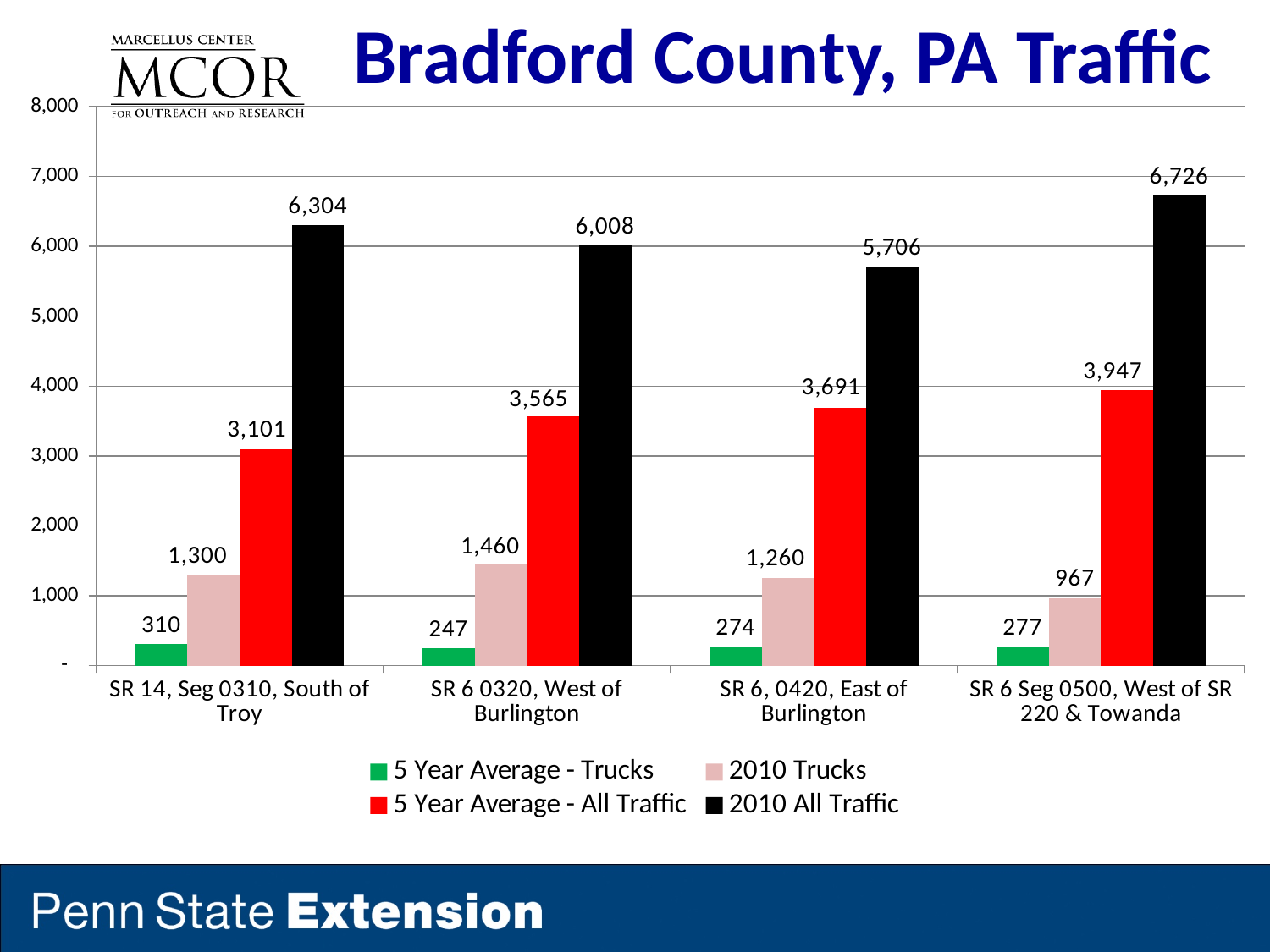
Which is larger for SR 6 0320, West of Burlington: the 2010 Trucks value or the 5 Year Average - Trucks value? 2010 Trucks What is the 2010 Trucks value for SR 6 0320, West of Burlington? 1,460 What colour are the bars for the 2010 All Traffic series? Black What is the 2010 All Traffic value for SR 6 Seg 0500, West of SR 220 & Towanda? 6,726 What is the 5 Year Average - All Traffic value for SR 6, 0420, East of Burlington? 3,691 Which road segment has the highest 2010 All Traffic value? SR 6 Seg 0500, West of SR 220 & Towanda How many road segments are shown on the x axis? 4 What kind of chart is shown on the slide? Bar chart What is the 5 Year Average - Trucks value for SR 14, Seg 0310, South of Troy? 310 Which road segment has the lowest 2010 Trucks value? SR 6 Seg 0500, West of SR 220 & Towanda What is the difference between the 2010 All Traffic and the 5 Year Average - All Traffic values for SR 14, Seg 0310, South of Troy? 3,203 How many series does the legend list? 4